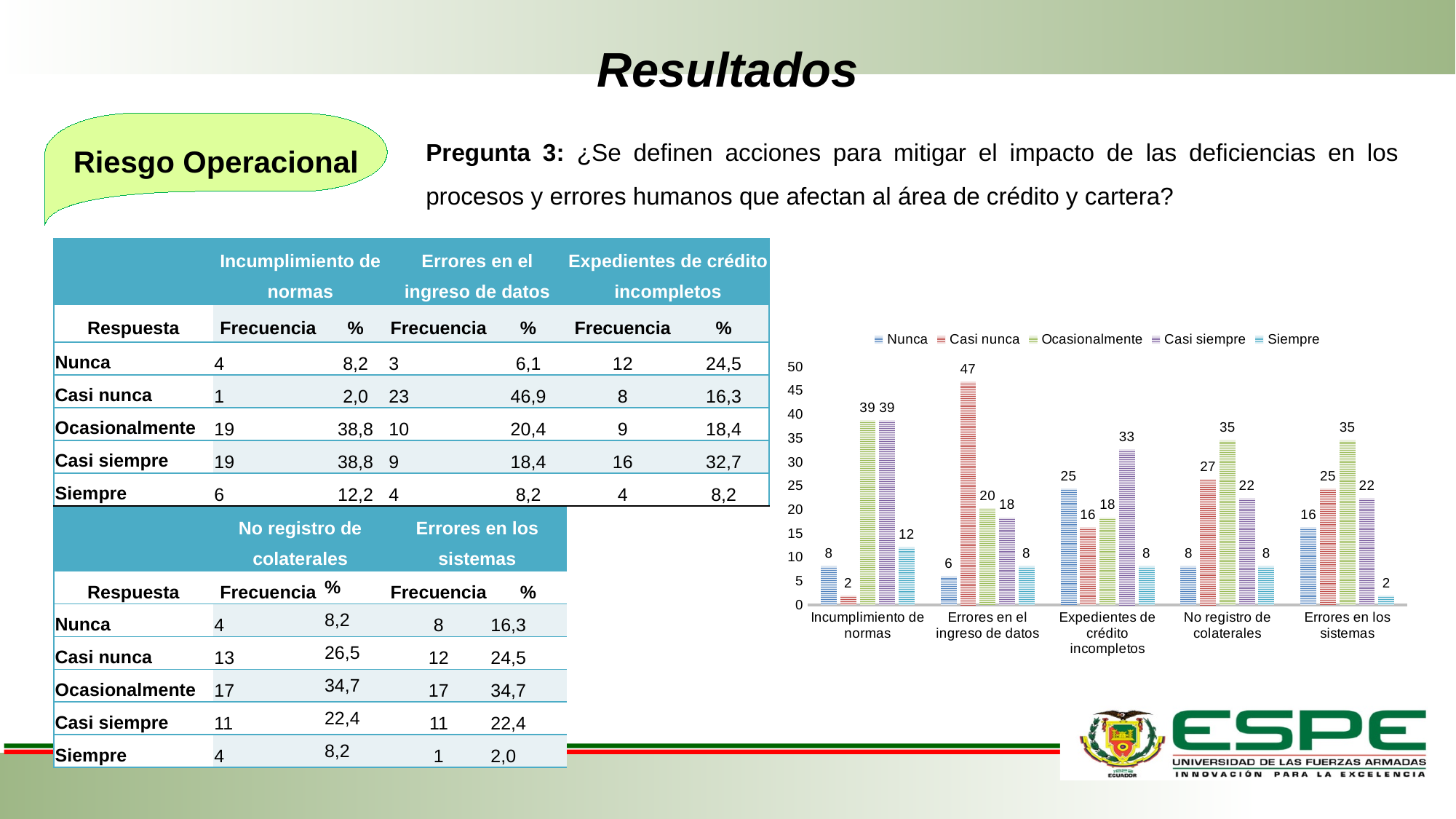
What is the value of the Siempre series for Errores en los sistemas? 2 What is the value of the Casi nunca series for Errores en el ingreso de datos? 47 Which series has the highest value for Errores en el ingreso de datos? Casi nunca Which series has the lowest value for Incumplimiento de normas? Casi nunca How many series does the chart legend list? 5 What type of chart is shown on the slide? bar chart How many categories are shown on the x axis of the chart? 5 What is the value of the Casi siempre series for Expedientes de crédito incompletos? 33 What is the difference between the Ocasionalmente and Nunca values for No registro de colaterales? 27 Which series is shown in red in the chart legend? Casi nunca Which is larger for Expedientes de crédito incompletos: the Nunca value or the Casi nunca value? Nunca Is the value of the Ocasionalmente series for Errores en los sistemas greater or less than 30? greater